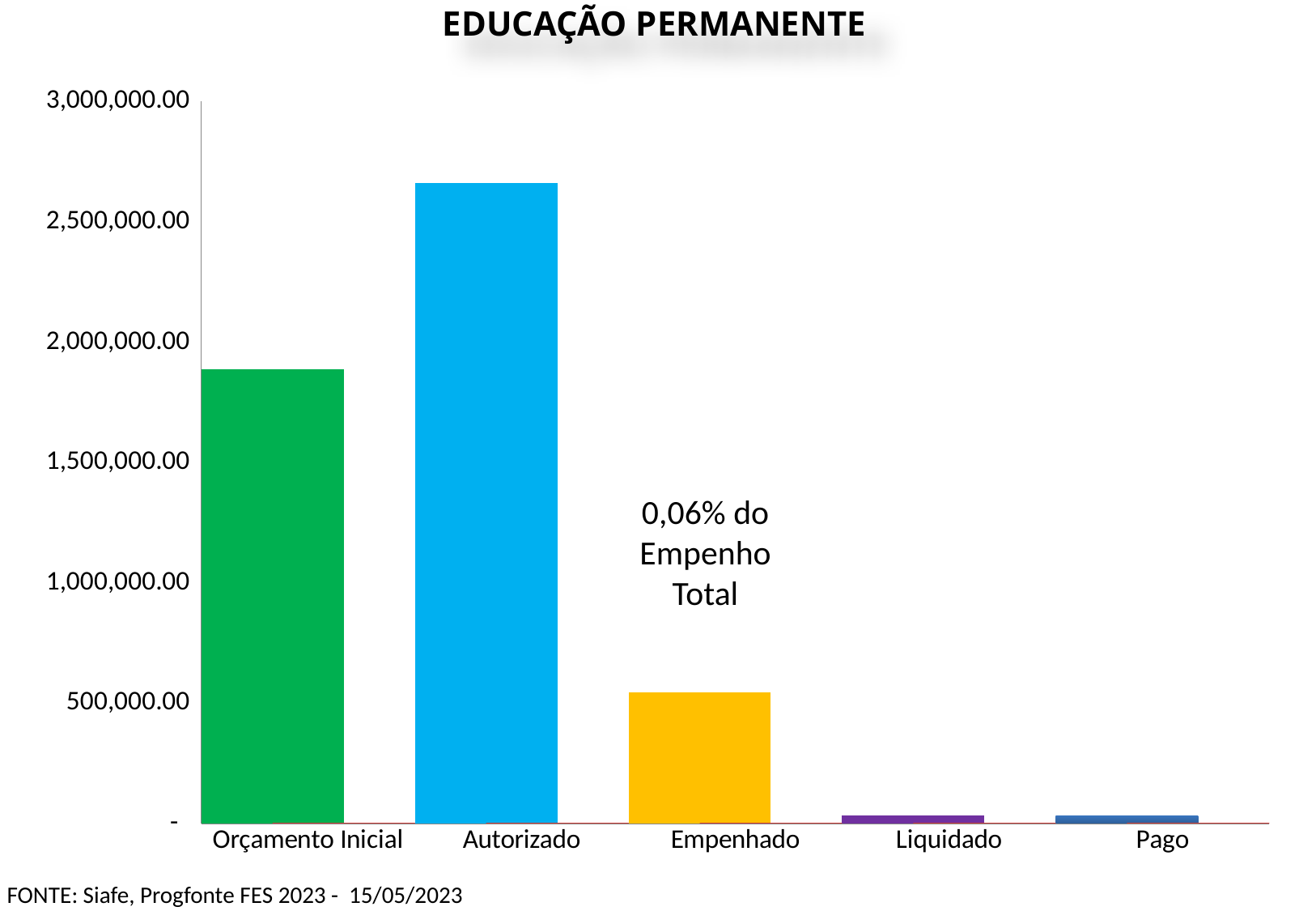
How many categories are shown on the x axis of the chart? 5 Is the value for Empenhado greater or less than 1,000,000.00? less Which is larger, the value for Empenhado or the value for Orçamento Inicial? Orçamento Inicial Is the value for Orçamento Inicial greater or less than 2,000,000.00? less From Autorizado to Pago, do the values rise or fall along the x axis? fall What kind of chart is shown on the slide? bar chart What percentage of the Empenho Total does the annotation on the chart state? 0,06% Is the value for Liquidado greater or less than 500,000.00? less What is the title of the chart? EDUCAÇÃO PERMANENTE Which is larger, the value for Orçamento Inicial or the value for Autorizado? Autorizado Which category has the highest value in the chart? Autorizado